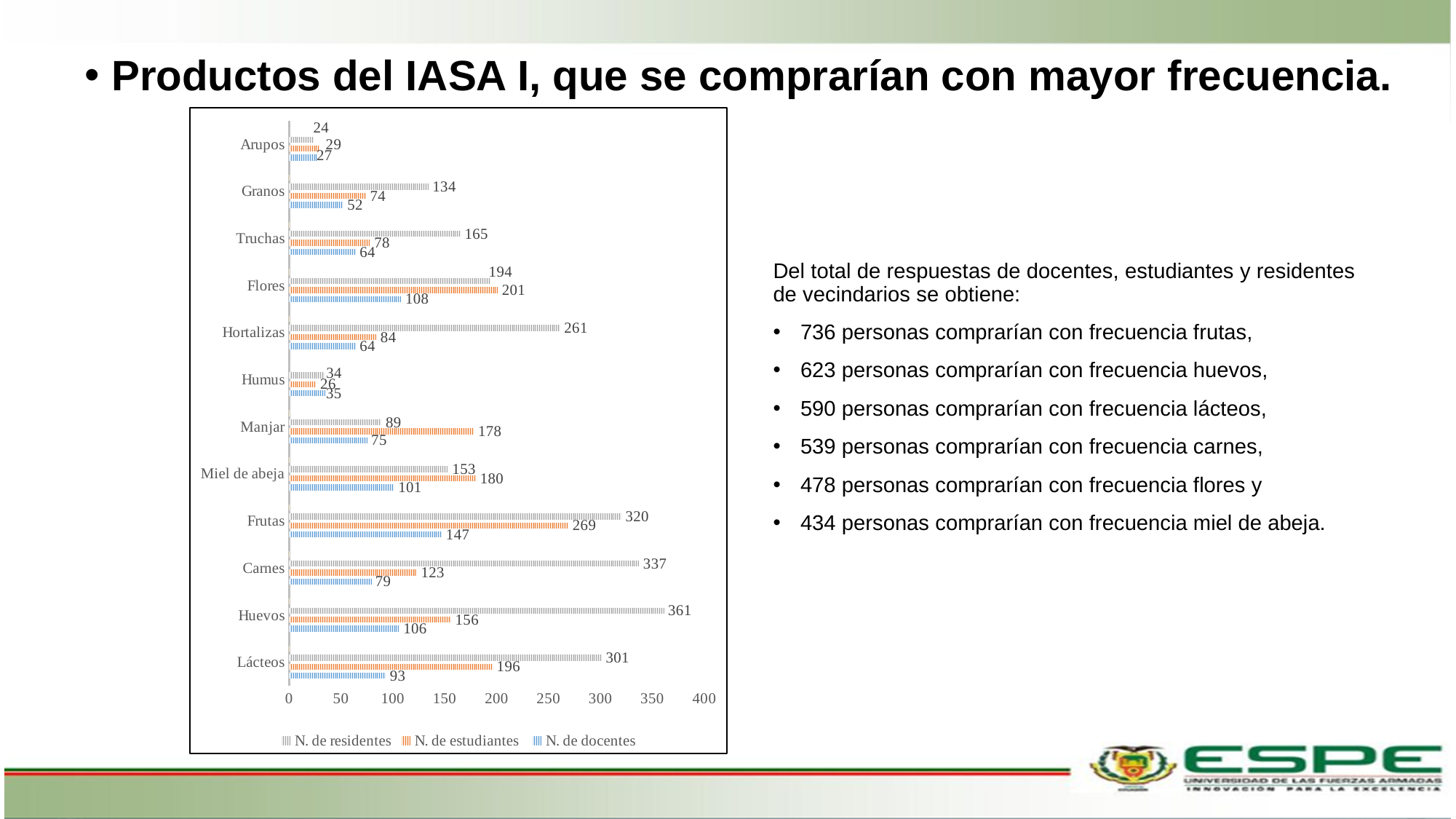
What is the difference between N. de residentes and N. de docentes for Frutas? 173 What is the value of N. de docentes for Lácteos? 93 What is the total of the three series for Huevos? 623 What type of chart is shown on the slide? Bar chart What is the value of N. de estudiantes for Flores? 201 How many product categories are shown in the chart? 12 Which category has the highest value for N. de residentes? Huevos Which category has the lowest value for N. de residentes? Arupos How many series does the chart legend list? 3 Which is larger for Manjar: N. de residentes or N. de estudiantes? N. de estudiantes What is the value of N. de residentes for Huevos? 361 Which category has the highest value for N. de estudiantes? Frutas